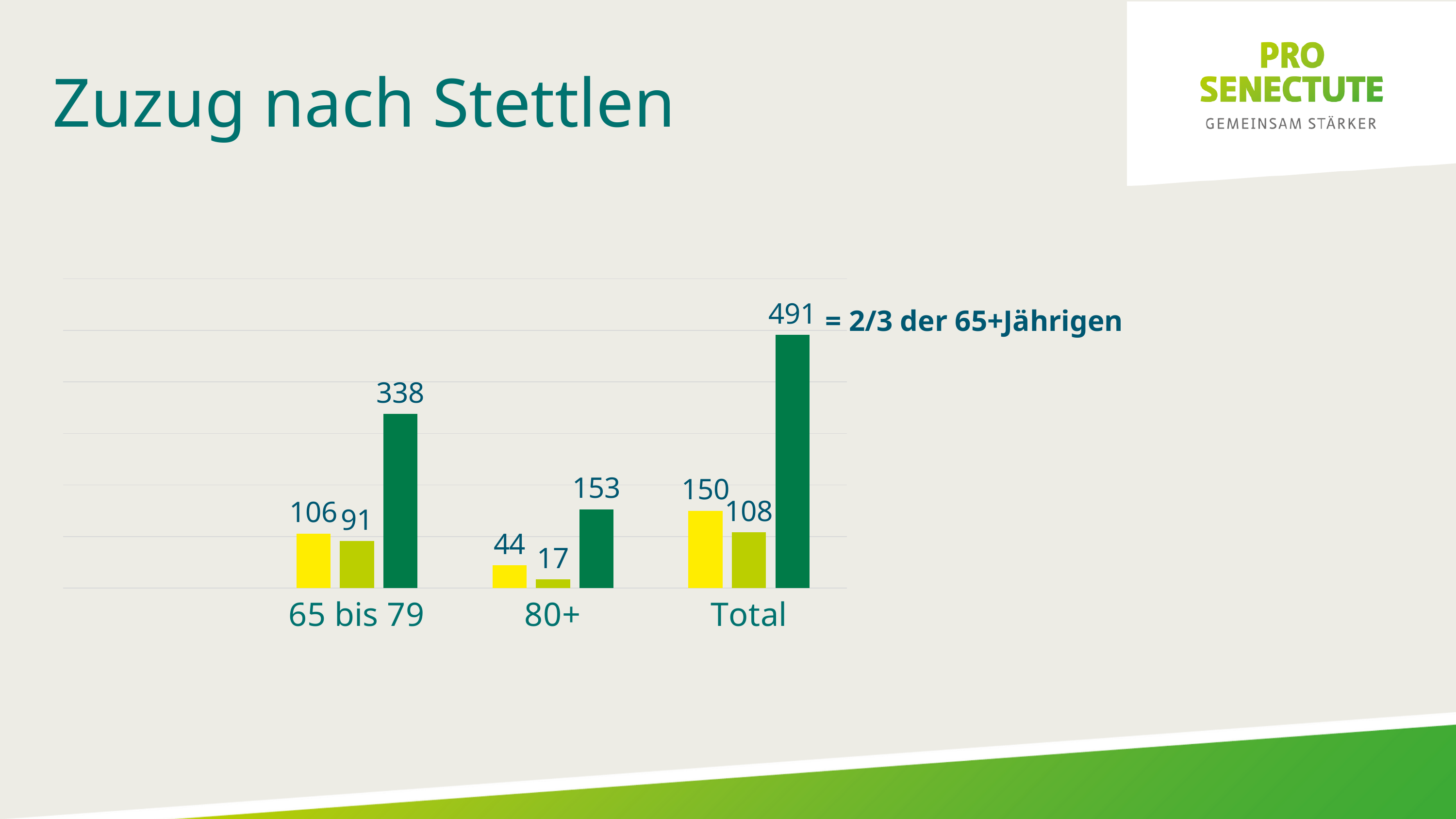
What kind of chart is shown on the slide? bar chart What is the difference between the dark green bars for "Total" and "65 bis 79"? 153 For the category "80+", which is larger: the yellow bar or the light green bar? the yellow bar Which category has the lowest light green bar? 80+ What is the value of the dark green bar for the category "Total"? 491 How many categories are shown on the x axis? 3 What is the value of the light green bar for the category "Total"? 108 What is the value of the dark green bar for the category "65 bis 79"? 338 What is the difference between the yellow bar and the light green bar for the category "65 bis 79"? 15 What is the value of the yellow bar for the category "80+"? 44 Which category has the highest dark green bar? Total What is the title of the slide containing the chart? Zuzug nach Stettlen